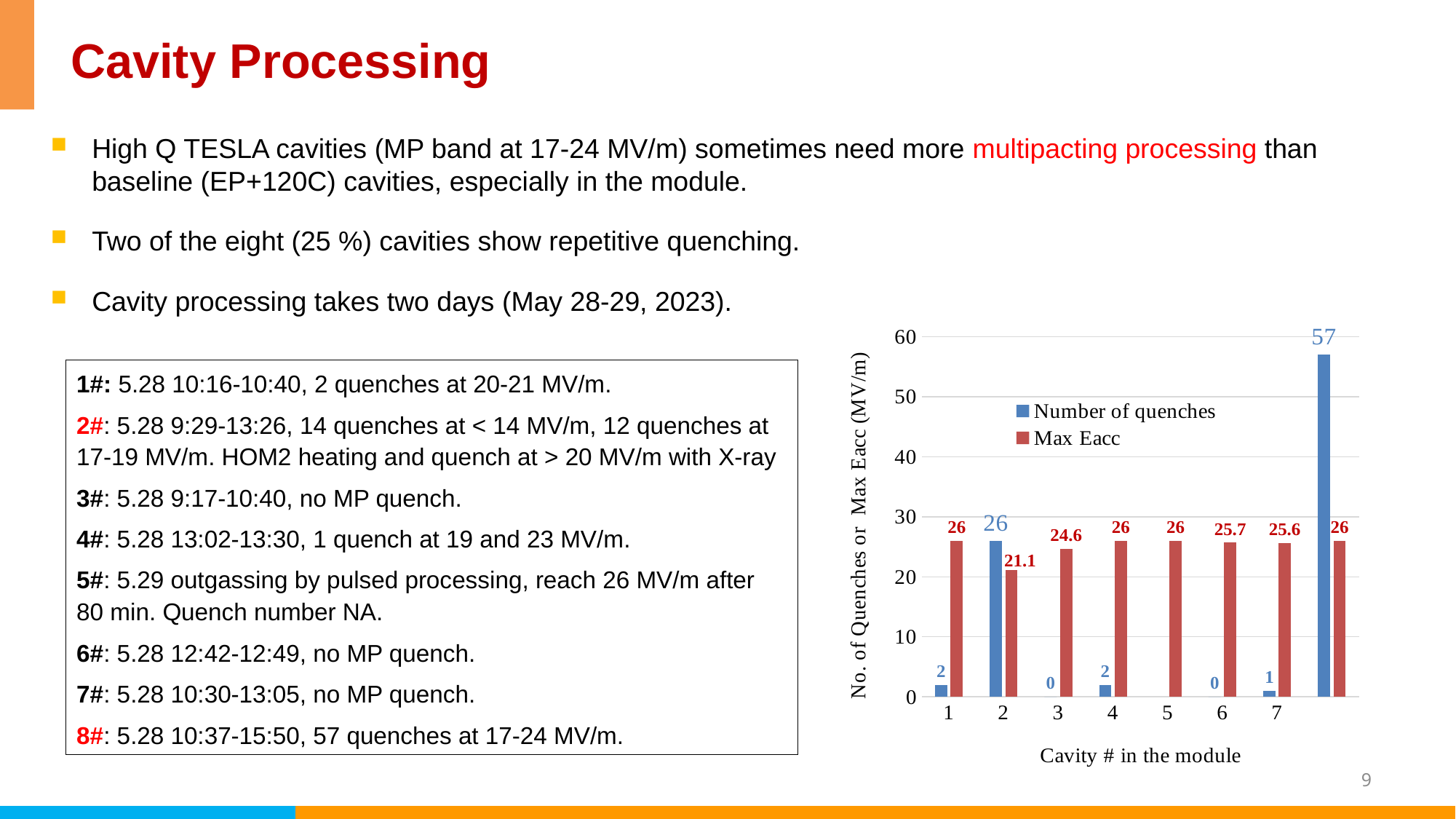
How many series does the legend list? 2 What is the Number of quenches for cavity 4? 2 What is the Max Eacc value for cavity 2? 21.1 What kind of chart is shown on the slide? bar chart What is the Number of quenches for cavity 7? 1 What is the Max Eacc value for cavity 3? 24.6 What is the difference between the Number of quenches for cavity 2 and cavity 1? 24 Which cavity has the lowest Max Eacc value? 2 Which has a higher Max Eacc value, cavity 6 or cavity 7? cavity 6 What is the highest Number of quenches value shown on the chart? 57 What is the difference between the Max Eacc values for cavity 1 and cavity 2? 4.9 Is the tallest Number of quenches bar greater or less than 50? greater